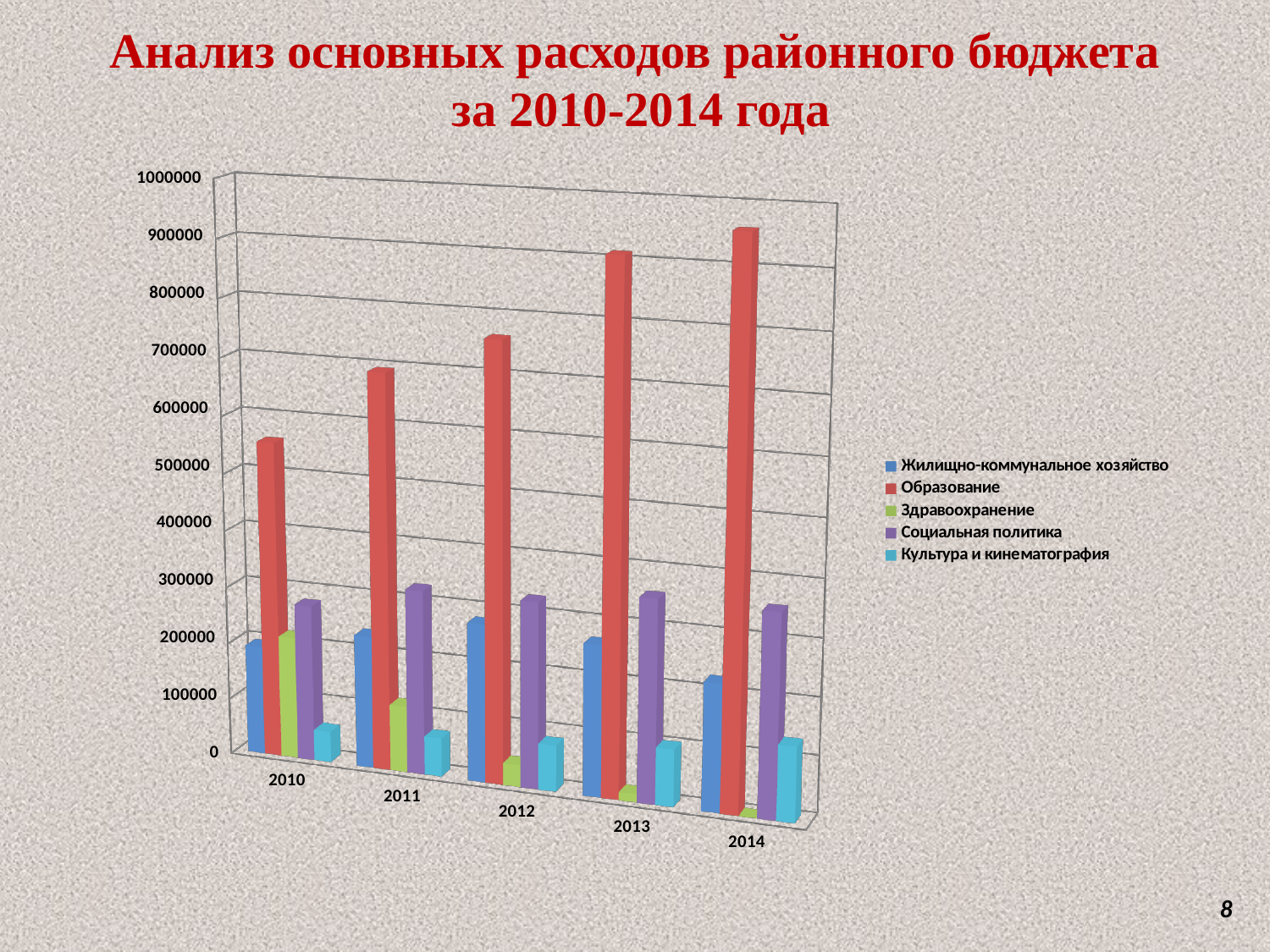
What kind of chart is shown on the slide? bar chart In which year is the value for Образование the highest? 2014 Do the values for Образование rise or fall from 2010 to 2014? rise How many series does the chart legend list? 5 Is the value for Образование in 2014 greater or less than 800000? greater Which series has the tallest bars in every year of the chart? Образование In 2014, which is larger: Жилищно-коммунальное хозяйство or Социальная политика? Социальная политика In which year is the value for Здравоохранение the highest? 2010 Is the value for Здравоохранение in 2011 greater or less than 200000? less Do the values for Здравоохранение rise or fall from 2010 to 2014? fall In which year is the value for Образование the lowest? 2010 How many years are shown on the x axis of the chart? 5